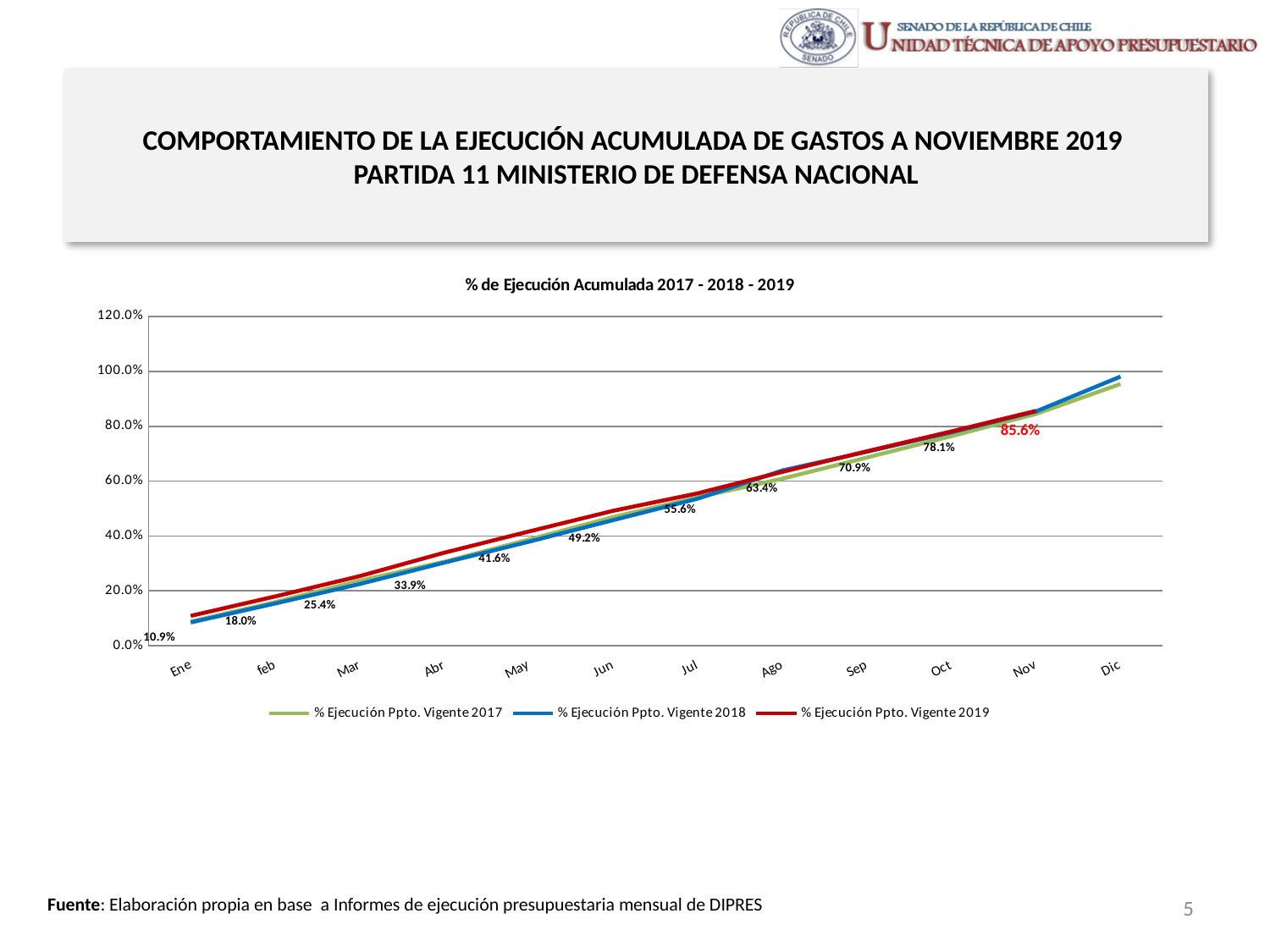
What is the value of % Ejecución Ppto. Vigente 2019 in Sep? 70.9% Is the value for % Ejecución Ppto. Vigente 2018 in Dic greater or less than 80.0%? greater Which month has the highest value for % Ejecución Ppto. Vigente 2019? Nov How many series does the legend list? 3 What is the value of % Ejecución Ppto. Vigente 2019 in Jun? 49.2% Which month has the lowest value for % Ejecución Ppto. Vigente 2019? Ene What is the value of % Ejecución Ppto. Vigente 2019 in Ene? 10.9% What is the value of % Ejecución Ppto. Vigente 2019 in Nov? 85.6% What is the difference between the % Ejecución Ppto. Vigente 2019 values for Feb and Ene? 7.1% Do the values of % Ejecución Ppto. Vigente 2019 rise or fall from Ene to Nov? Rise What is the difference between the % Ejecución Ppto. Vigente 2019 values for Nov and Oct? 7.5% What kind of chart is shown on the slide? Line chart